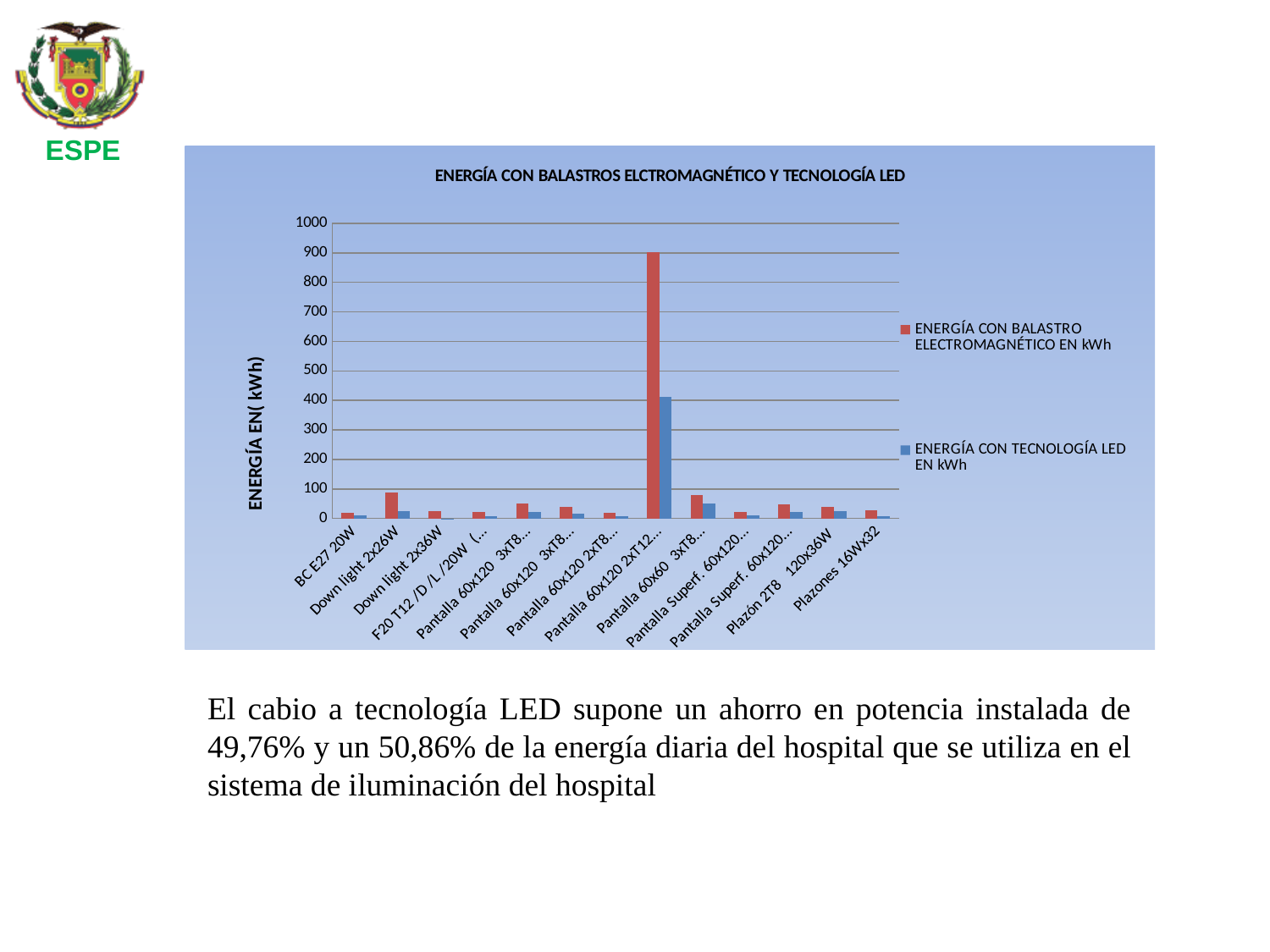
Which series has the larger value for Down light 2x26W: ENERGÍA CON BALASTRO ELECTROMAGNÉTICO EN kWh or ENERGÍA CON TECNOLOGÍA LED EN kWh? ENERGÍA CON BALASTRO ELECTROMAGNÉTICO EN kWh For Pantalla 60x120 2xT12..., which series has the larger value: ENERGÍA CON BALASTRO ELECTROMAGNÉTICO EN kWh or ENERGÍA CON TECNOLOGÍA LED EN kWh? ENERGÍA CON BALASTRO ELECTROMAGNÉTICO EN kWh Is the value for ENERGÍA CON BALASTRO ELECTROMAGNÉTICO EN kWh for Down light 2x26W greater or less than 100? less Is the value for ENERGÍA CON TECNOLOGÍA LED EN kWh for Pantalla 60x120 2xT12... greater or less than 500? less What kind of chart is shown on the slide? bar chart What is the title of the chart? ENERGÍA CON BALASTROS ELCTROMAGNÉTICO Y TECNOLOGÍA LED Which category has the highest value for ENERGÍA CON BALASTRO ELECTROMAGNÉTICO EN kWh? Pantalla 60x120 2xT12... What is the label of the y axis? ENERGÍA EN( kWh) How many categories are shown on the x axis of the chart? 13 How many series does the legend list? 2 Which category has the highest value for ENERGÍA CON TECNOLOGÍA LED EN kWh? Pantalla 60x120 2xT12... Is the value for ENERGÍA CON BALASTRO ELECTROMAGNÉTICO EN kWh for Pantalla 60x120 2xT12... greater or less than 800? greater